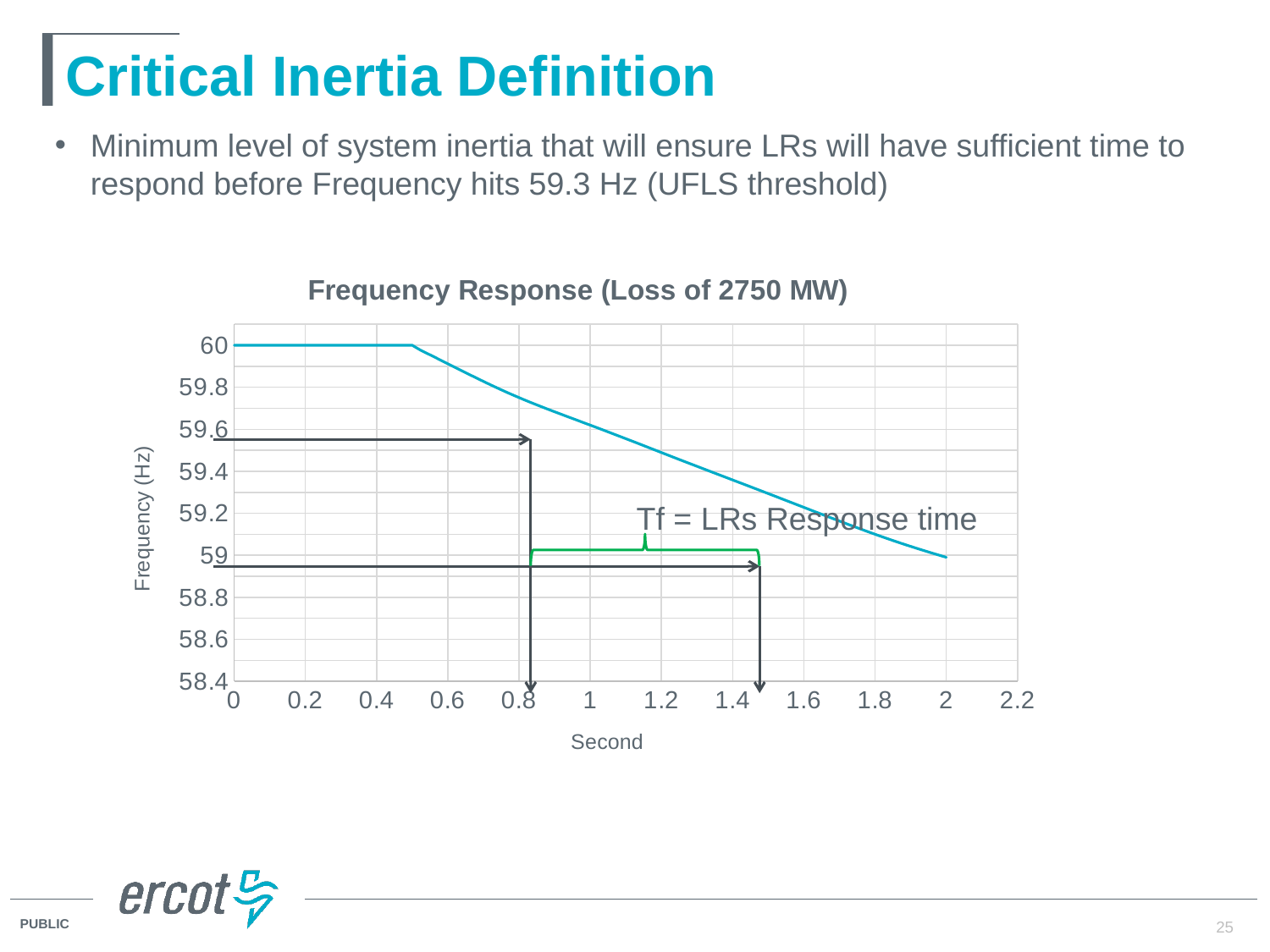
Is the frequency at 1 second greater or less than 59.4? greater What is the highest value shown on the y axis of the chart? 60 What kind of chart is shown on the slide? line chart Is the frequency at 0.4 seconds greater or less than 59.8? greater Is the frequency at 2 seconds greater or less than 59.2? less What is the lowest value shown on the y axis of the chart? 58.4 What is the title of the chart? Frequency Response (Loss of 2750 MW) Does the frequency rise or fall along the x axis after about 0.5 seconds? fall Which is larger, the frequency at 0.2 seconds or the frequency at 1.8 seconds? 0.2 seconds What is the frequency value at 0 seconds? 60